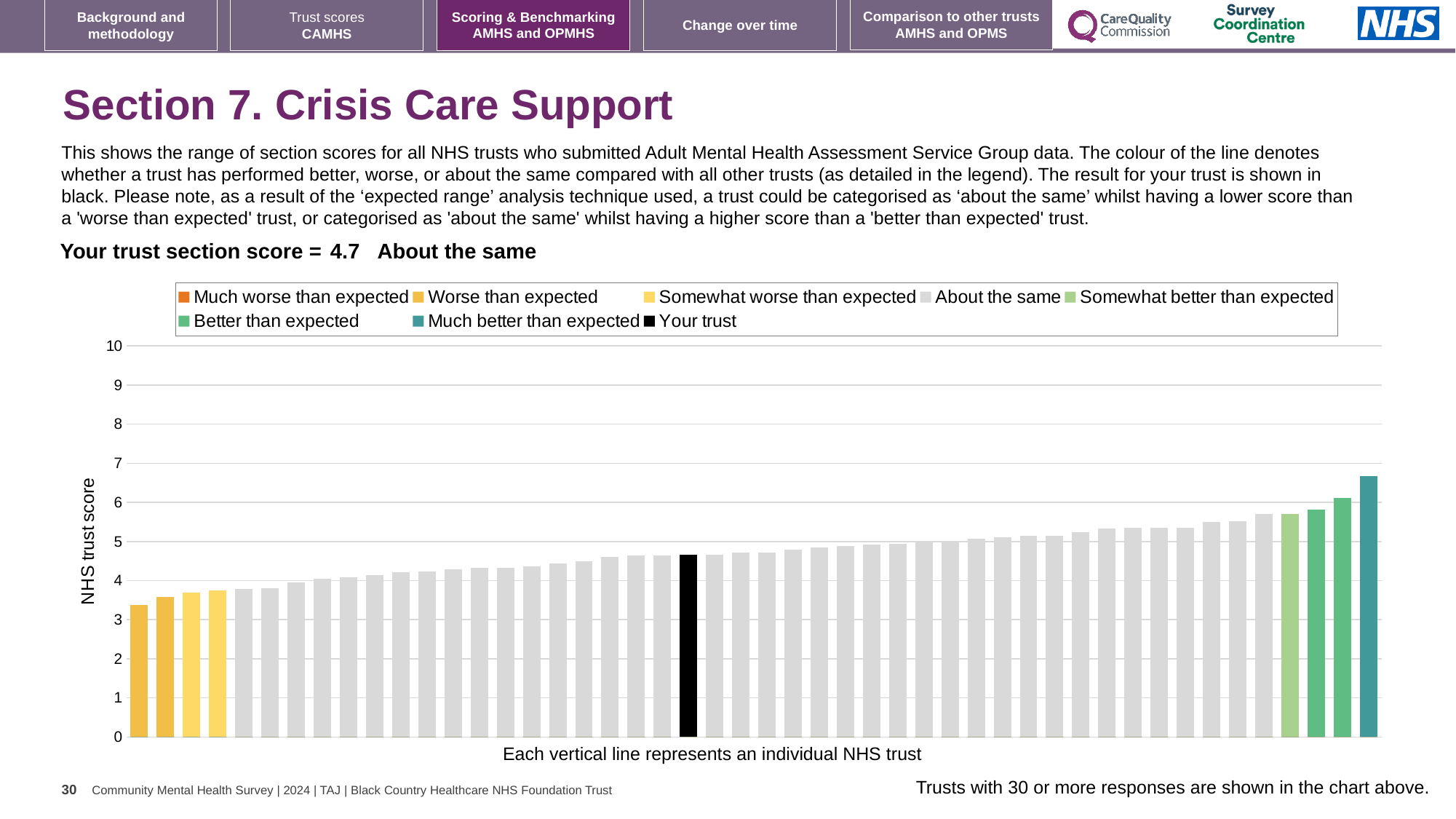
Is the value of the shortest bar in the chart greater or less than 4? less According to the chart's x-axis caption, what does each vertical line represent? an individual NHS trust Which category is your trust's section score placed in? About the same What is the label on the vertical axis of the chart? NHS trust score Do the bar heights rise or fall from left to right across the chart? rise Is the value of the tallest bar in the chart greater or less than 6? greater Which legend category does the tallest bar in the chart belong to? Much better than expected Is the value for your trust (the black bar) greater or less than 5? less What is the section score for your trust? 4.7 How many bars are coloured as 'Much better than expected'? 1 What kind of chart is shown on the slide? bar chart How many entries does the chart legend list? 8